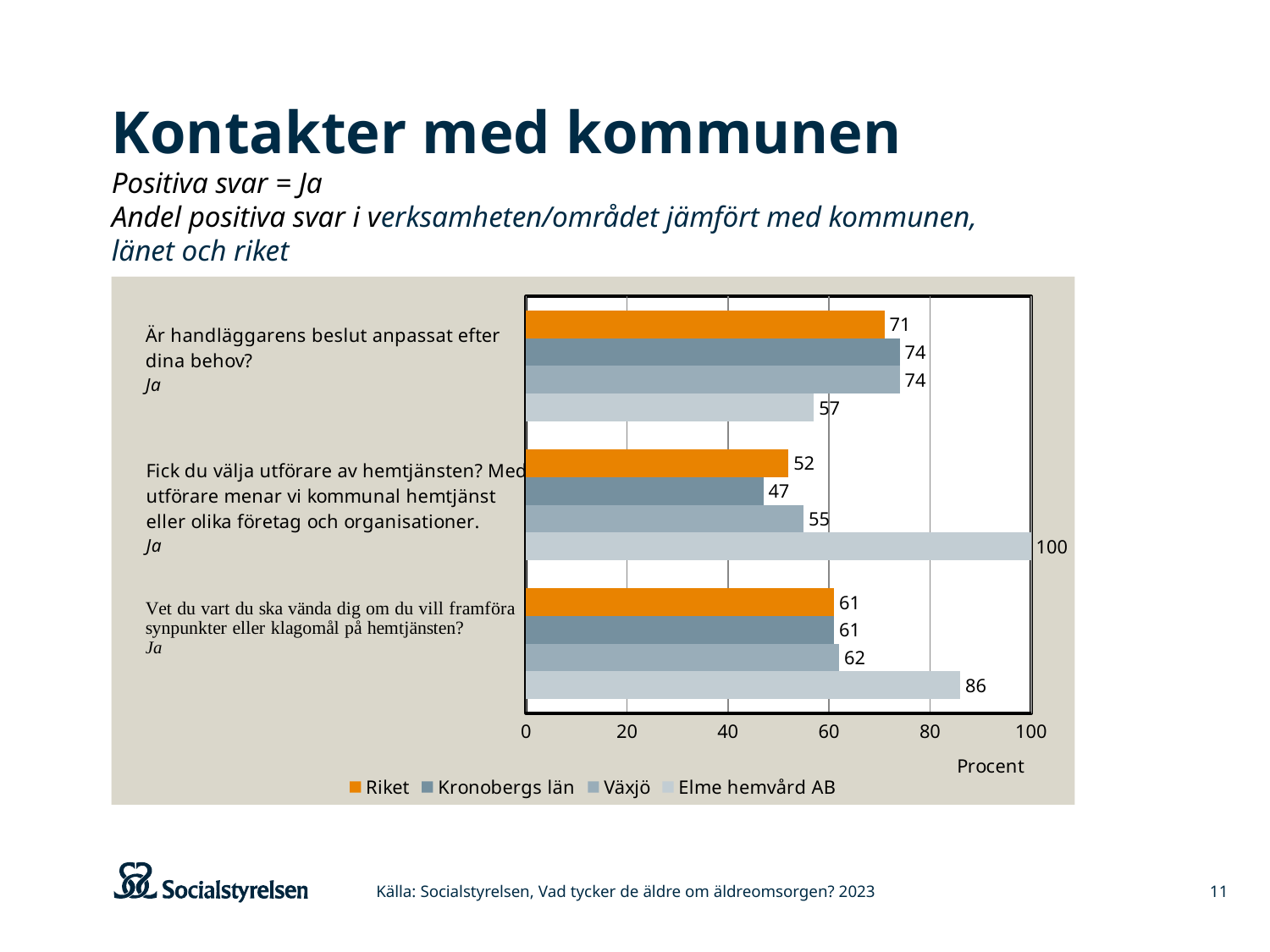
What is the value for Elme hemvård AB on the question "Fick du välja utförare av hemtjänsten?"? 100 What is the difference between Kronobergs län and Elme hemvård AB on the question "Är handläggarens beslut anpassat efter dina behov?"? 17 Which series has the highest value on the question "Vet du vart du ska vända dig om du vill framföra synpunkter eller klagomål på hemtjänsten?"? Elme hemvård AB What is the value for Riket on the question "Är handläggarens beslut anpassat efter dina behov?"? 71 How many series does the legend list? 4 What is the value for Kronobergs län on the question "Vet du vart du ska vända dig om du vill framföra synpunkter eller klagomål på hemtjänsten?"? 61 What is the difference between Elme hemvård AB and Växjö on the question "Vet du vart du ska vända dig om du vill framföra synpunkter eller klagomål på hemtjänsten?"? 24 Which series has the lowest value on the question "Fick du välja utförare av hemtjänsten?"? Kronobergs län What label is shown on the horizontal axis of the chart? Procent What kind of chart is shown on the slide? bar chart How many question categories are plotted on the chart? 3 On the question "Är handläggarens beslut anpassat efter dina behov?", which is larger: the value for Växjö or the value for Elme hemvård AB? Växjö